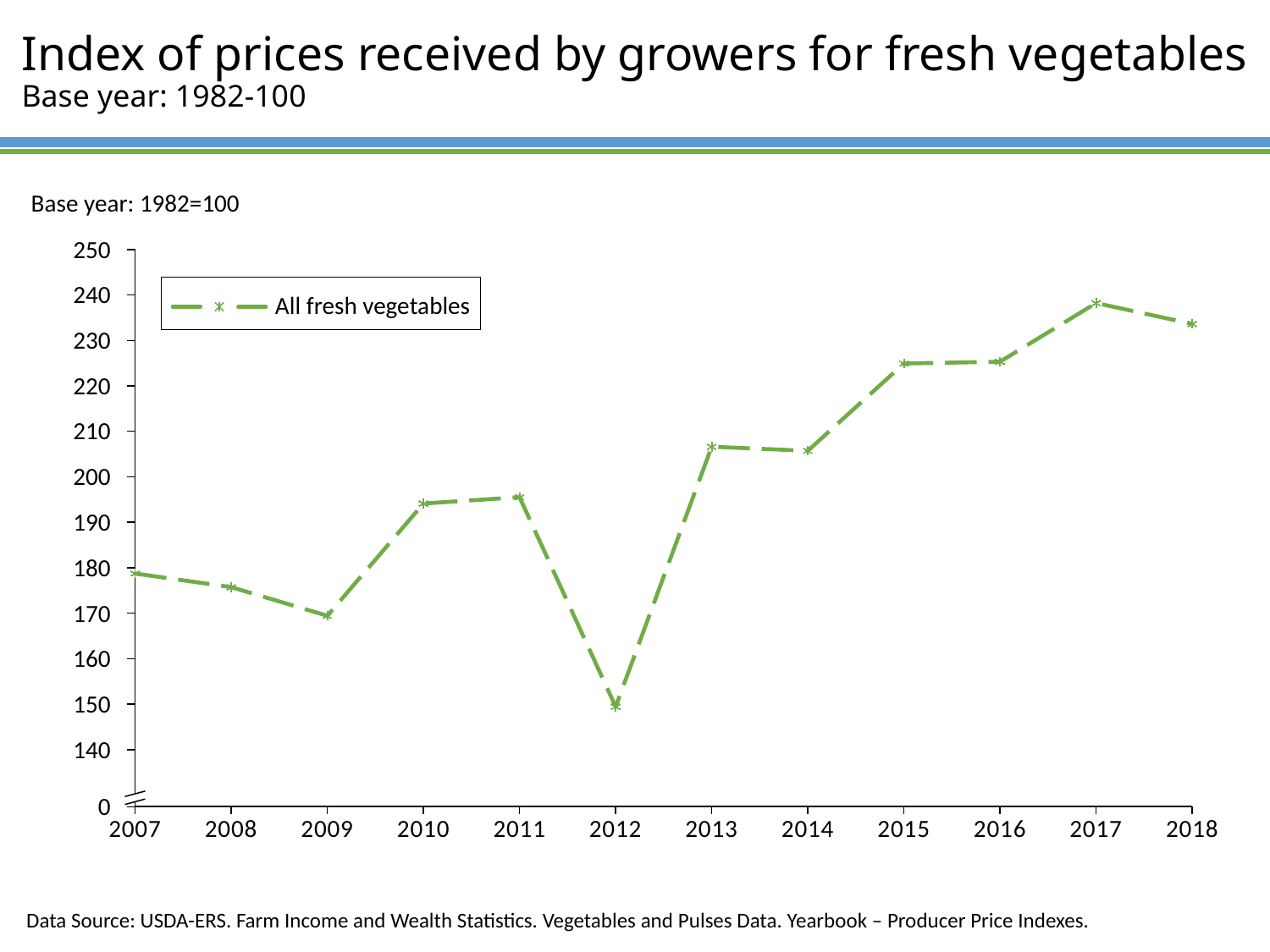
Which year has the higher index value, 2010 or 2012? 2010 Is the value for 2017 greater or less than 230? greater In which year is the index of prices received by growers for fresh vegetables highest? 2017 Is the value for 2009 greater or less than 180? less How many years are plotted along the x axis? 12 Is the value for 2013 greater or less than 200? greater Does the index rise or fall from 2012 to 2017? rise What is the name of the series shown in the legend? All fresh vegetables In which year is the index of prices received by growers for fresh vegetables lowest? 2012 How many series does the legend list? 1 What kind of chart is shown on the slide? line chart